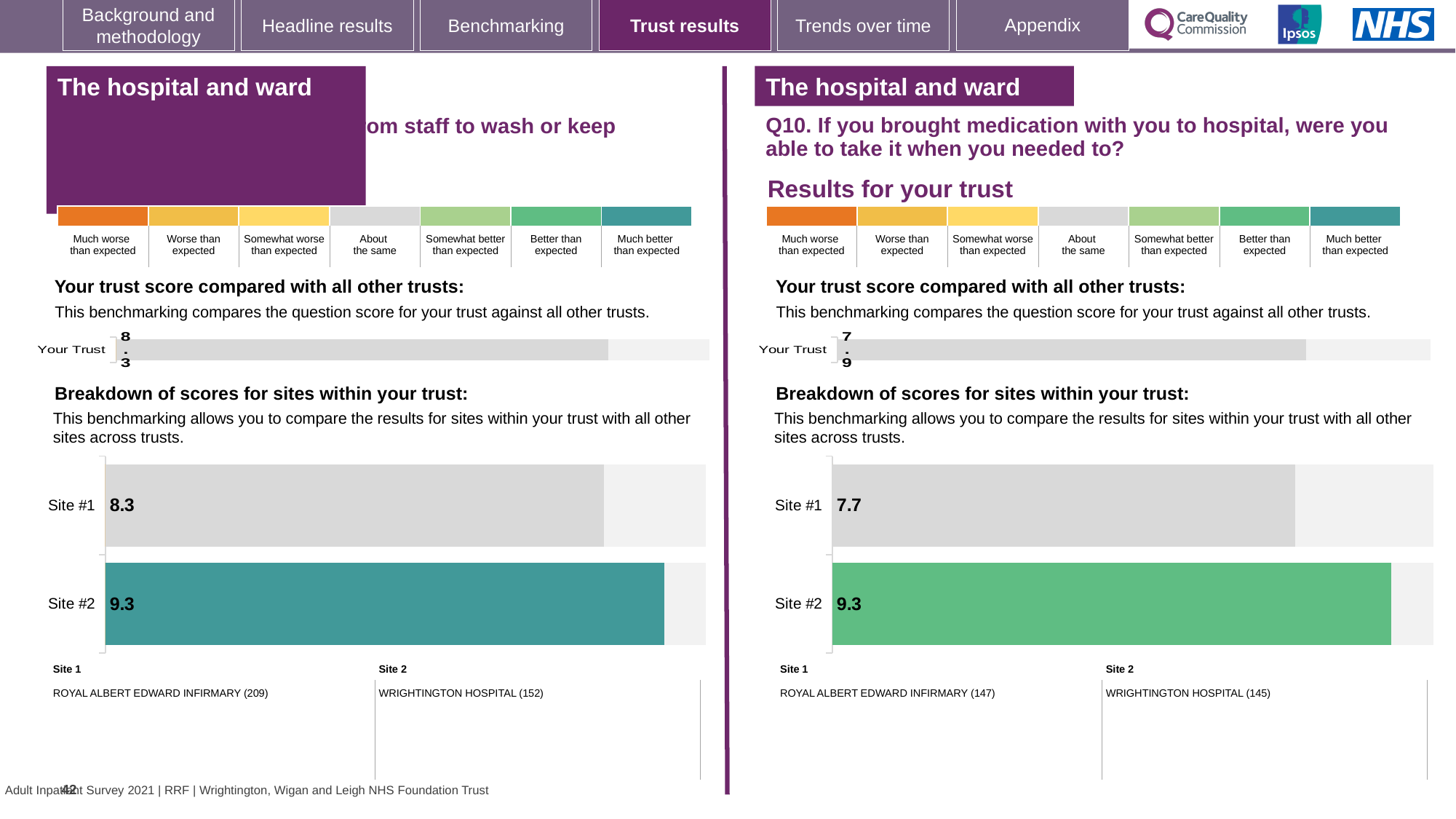
On the right-hand chart (Q10, medication), what is the 'Your Trust' score? 7.9 On the right-hand chart (Q10, medication), which site has the higher score? Site #2 On the left-hand chart, which site has the lower score? Site #1 How many sites are shown in the site breakdown chart on the right-hand side? 2 On the left-hand chart, what is the score for Site #2? 9.3 On the right-hand chart (Q10, medication), what is the score for Site #2? 9.3 What type of chart is used to show the breakdown of scores for sites on the right-hand side? Bar chart On the left-hand chart, what is the difference between the Site #2 and Site #1 scores? 1.0 On the right-hand chart (Q10, medication), what is the score for Site #1? 7.7 On the left-hand chart, what is the 'Your Trust' score? 8.3 On the right-hand chart (Q10, medication), what is the difference between the Site #2 and Site #1 scores? 1.6 On the left-hand chart, what is the score for Site #1? 8.3